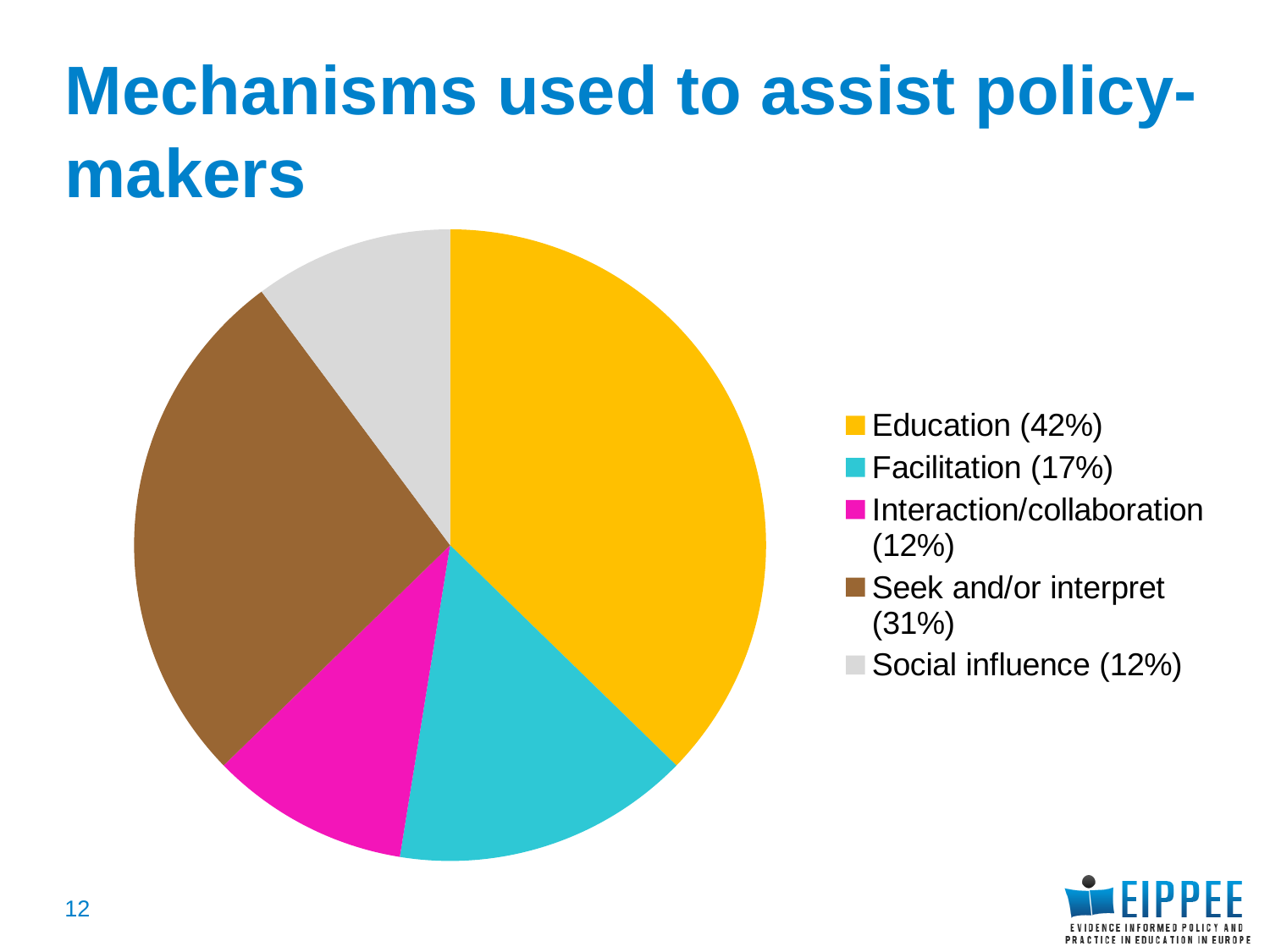
Which is larger, the share for Facilitation or the share for Interaction/collaboration? Facilitation What is the difference in percentage points between Education and Seek and/or interpret? 11 What share of the pie does Seek and/or interpret account for? 31% Which is larger, the share for Seek and/or interpret or the share for Facilitation? Seek and/or interpret What kind of chart is shown on the slide? pie chart Which mechanism has the largest share of the pie? Education What colour is the Education slice of the pie? yellow What share of the pie does Education account for? 42% What share of the pie does Facilitation account for? 17% What is the difference in percentage points between Facilitation and Social influence? 5 What is the title of the chart on the slide? Mechanisms used to assist policy-makers How many slices does the pie chart have? 5